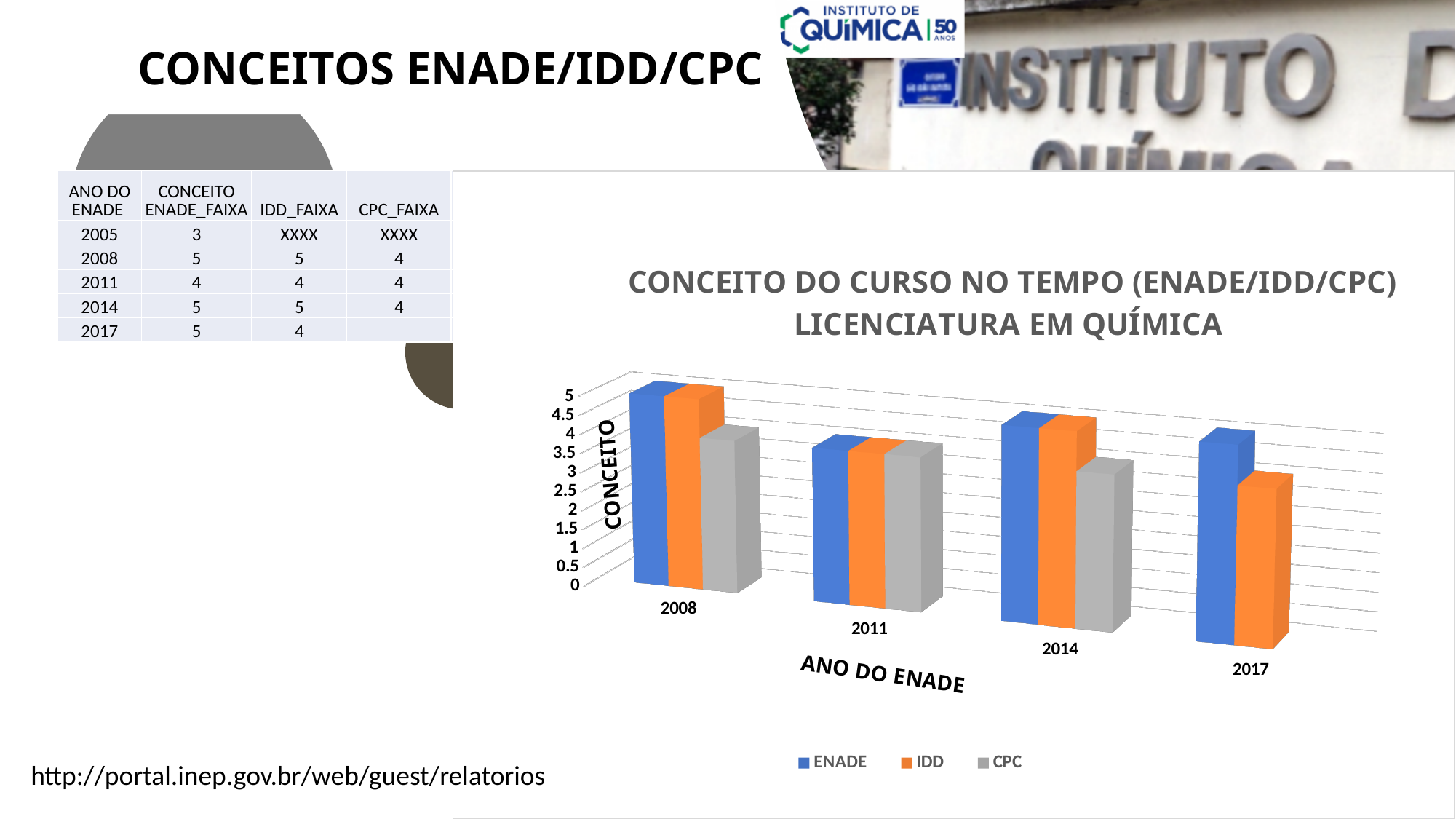
What is the IDD value for 2017? 4 What is the CPC value for 2014? 4 How many series does the chart legend list? 3 For 2017, which is larger, the ENADE value or the IDD value? ENADE Is the CPC value for 2008 greater or less than 5? less In which year is the ENADE value lowest? 2011 What is the difference between the ENADE and IDD values for 2017? 1 What is the ENADE value for 2011? 4 How many years are shown on the x axis of the chart? 4 Is the ENADE value for 2011 greater or less than 5? less What kind of chart is shown on the slide? bar chart What is the label of the vertical axis of the chart? CONCEITO